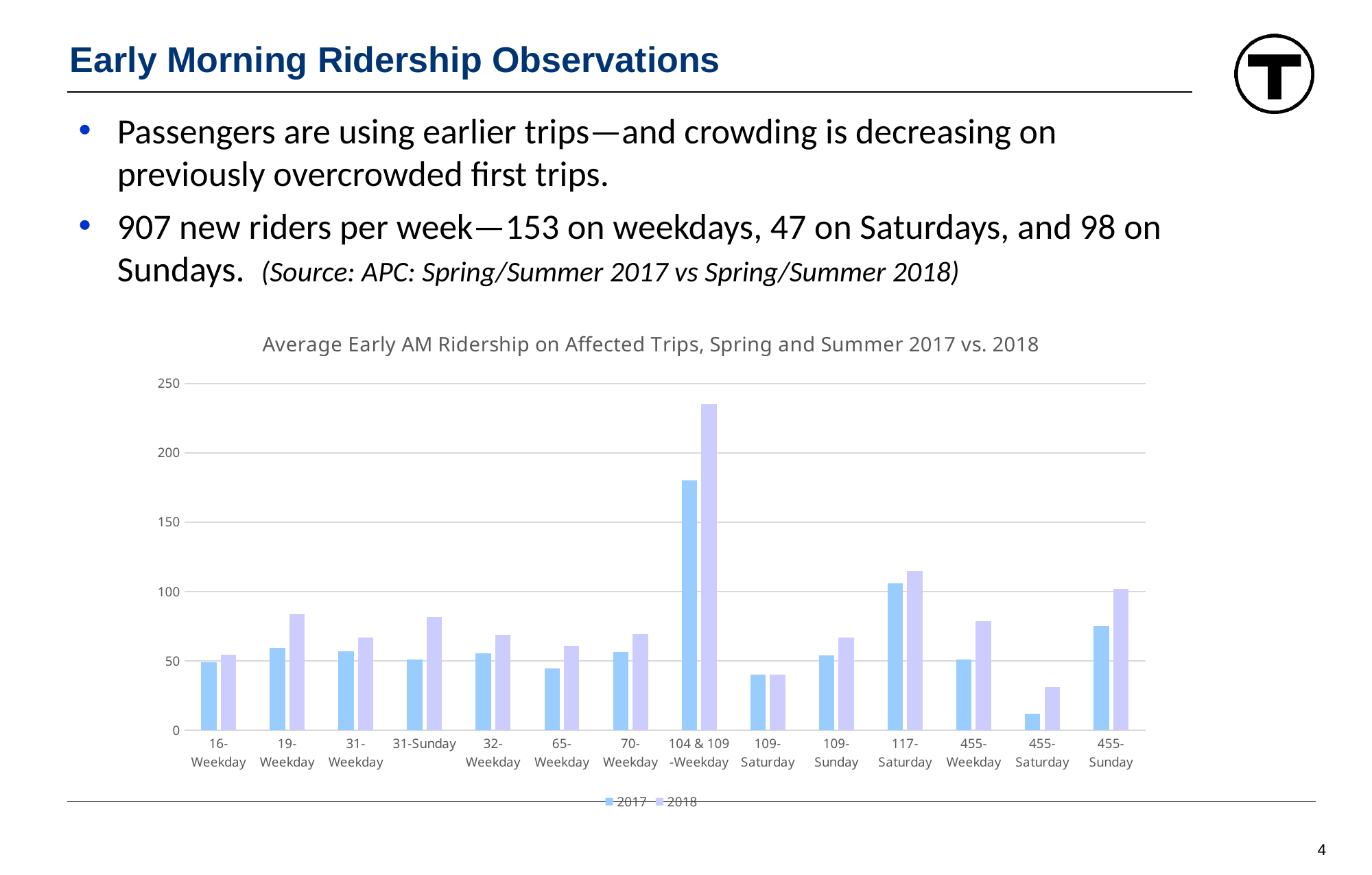
Which category has the lowest 2017 value? 455-Saturday For 455-Sunday, which series has the larger value, 2017 or 2018? 2018 Is the 2017 value for 455-Saturday greater or less than 50? less Is the 2017 value for 104 & 109-Weekday greater or less than 150? greater Which category has the lowest 2018 value? 455-Saturday Which category has the highest 2018 value? 104 & 109-Weekday What is the title of the chart? Average Early AM Ridership on Affected Trips, Spring and Summer 2017 vs. 2018 How many categories are shown on the x axis of the chart? 14 Is the 2018 value for 117-Saturday greater or less than 100? greater How many series does the chart legend list? 2 What kind of chart is shown on the slide? bar chart